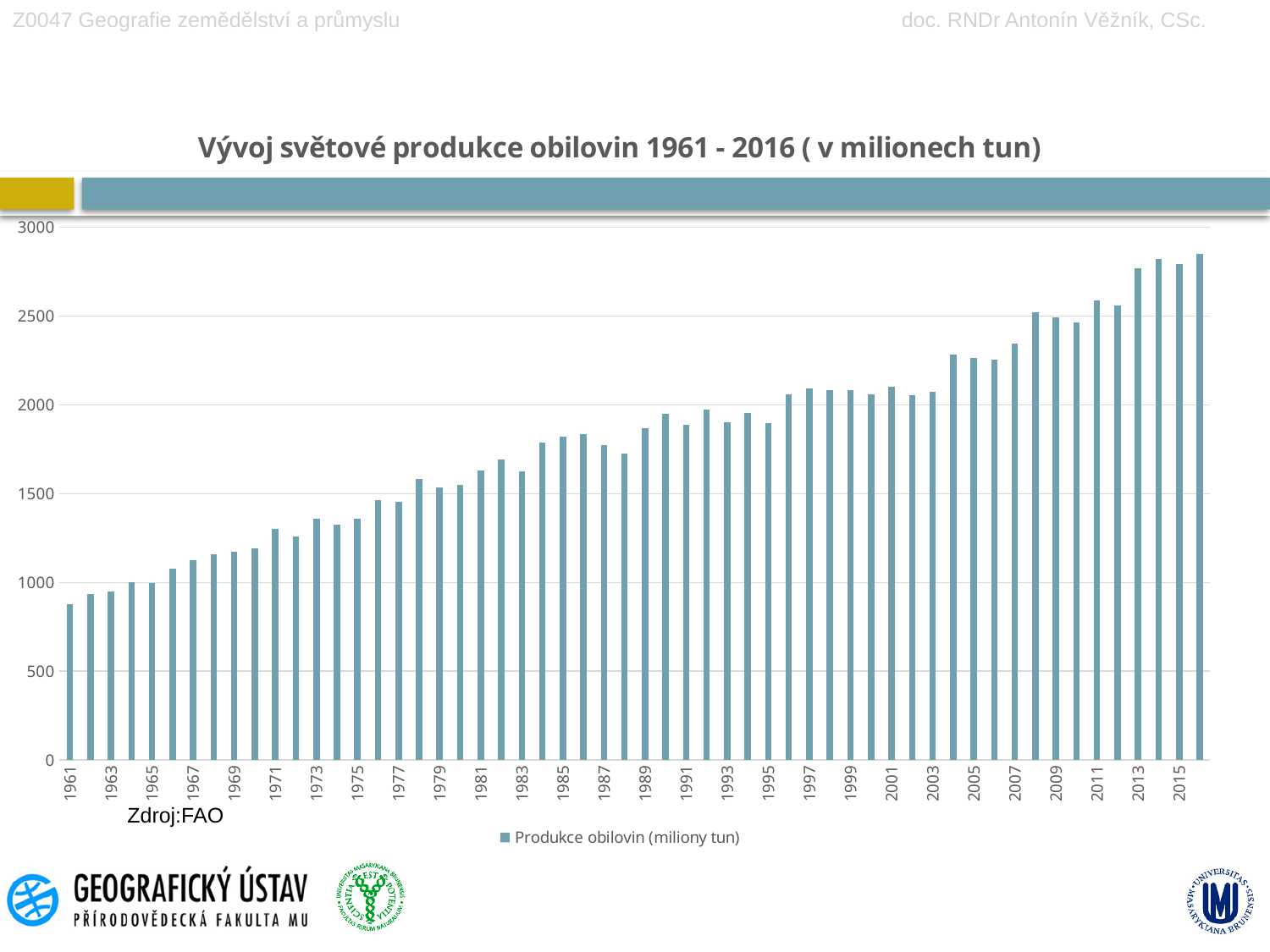
What kind of chart is shown on the slide? bar chart Is the value for 2016 greater or less than 2500? greater Is the value for 1985 greater or less than 1500? greater How many series does the legend list? 1 Is the value for 2007 greater or less than 2500? less Which year has the larger value, 1975 or 1995? 1995 Which year has the highest cereal production? 2016 What is the title of the chart? Vývoj světové produkce obilovin 1961 - 2016 ( v milionech tun) Which year has the lowest cereal production? 1961 Do the values generally rise or fall from 1961 to 2016? rise What is the legend entry for the plotted series? Produkce obilovin (miliony tun)